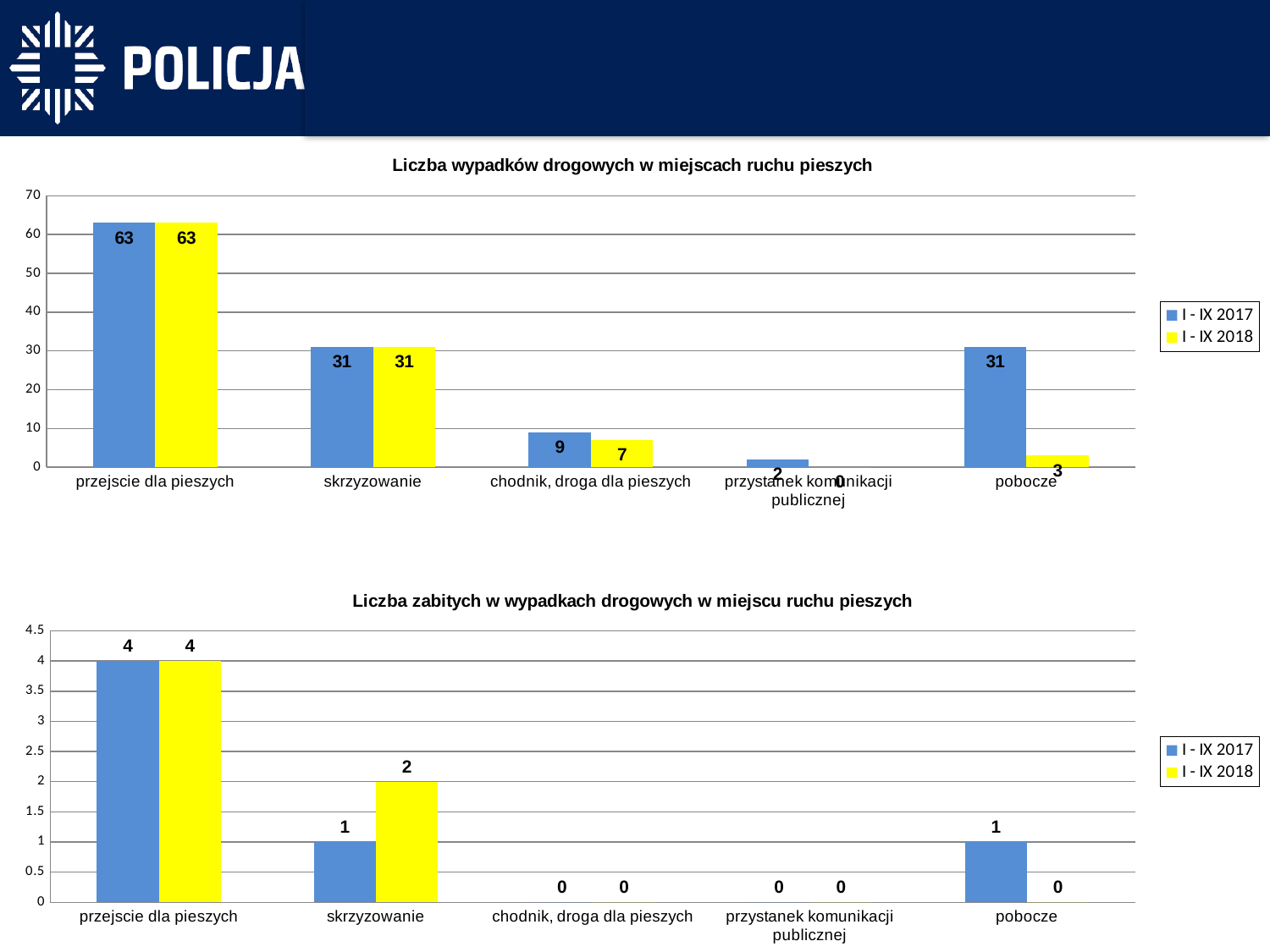
In the chart 'Liczba zabitych w wypadkach drogowych w miejscu ruchu pieszych', what is the value for 'skrzyzowanie' in the I - IX 2018 series? 2 In the chart 'Liczba wypadków drogowych w miejscach ruchu pieszych', which category has the highest value in the I - IX 2017 series? przejscie dla pieszych In the chart 'Liczba zabitych w wypadkach drogowych w miejscu ruchu pieszych', what colour are the bars for the I - IX 2018 series? yellow In the chart 'Liczba wypadków drogowych w miejscach ruchu pieszych', what is the difference between the I - IX 2017 and I - IX 2018 values for 'pobocze'? 28 How many categories are shown on the x axis of the chart 'Liczba wypadków drogowych w miejscach ruchu pieszych'? 5 What kind of chart is the chart 'Liczba zabitych w wypadkach drogowych w miejscu ruchu pieszych'? bar chart In the chart 'Liczba zabitych w wypadkach drogowych w miejscu ruchu pieszych', which category has the highest value in the I - IX 2018 series? przejscie dla pieszych How many series does the legend of the chart 'Liczba zabitych w wypadkach drogowych w miejscu ruchu pieszych' list? 2 In the chart 'Liczba wypadków drogowych w miejscach ruchu pieszych', is the I - IX 2017 value for 'chodnik, droga dla pieszych' larger or smaller than the I - IX 2018 value? larger In the chart 'Liczba wypadków drogowych w miejscach ruchu pieszych', which category has the lowest value in the I - IX 2018 series? przystanek komunikacji publicznej In the chart 'Liczba wypadków drogowych w miejscach ruchu pieszych', what is the value for 'pobocze' in the I - IX 2017 series? 31 In the chart 'Liczba wypadków drogowych w miejscach ruchu pieszych', what is the value for 'przejscie dla pieszych' in the I - IX 2018 series? 63